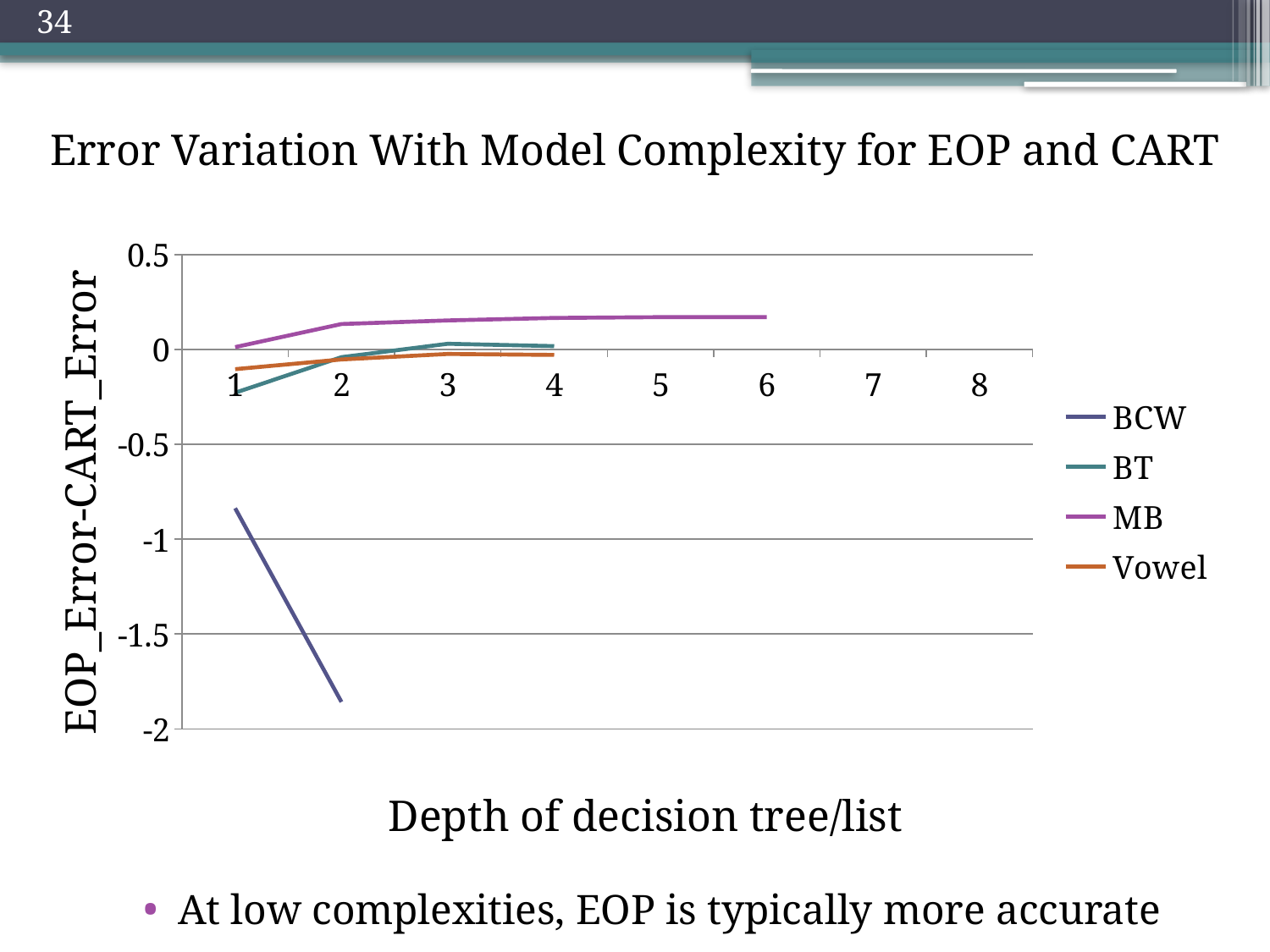
Is the value for BCW at depth 1 greater or less than -0.5? less Is the value for BCW at depth 2 greater or less than -1.5? less Does the MB line rise or fall as depth increases from 1 to 6? rise Is the value for MB at depth 6 greater or less than 0? greater Which series are listed in the legend? BCW, BT, MB, Vowel What is the label of the x axis? Depth of decision tree/list What kind of chart is shown on the slide? line chart At depth 2, which series has the larger value, MB or BCW? MB How many series does the legend list? 4 Does the BCW line rise or fall as depth increases from 1 to 2? fall How many depth values are marked on the x axis? 8